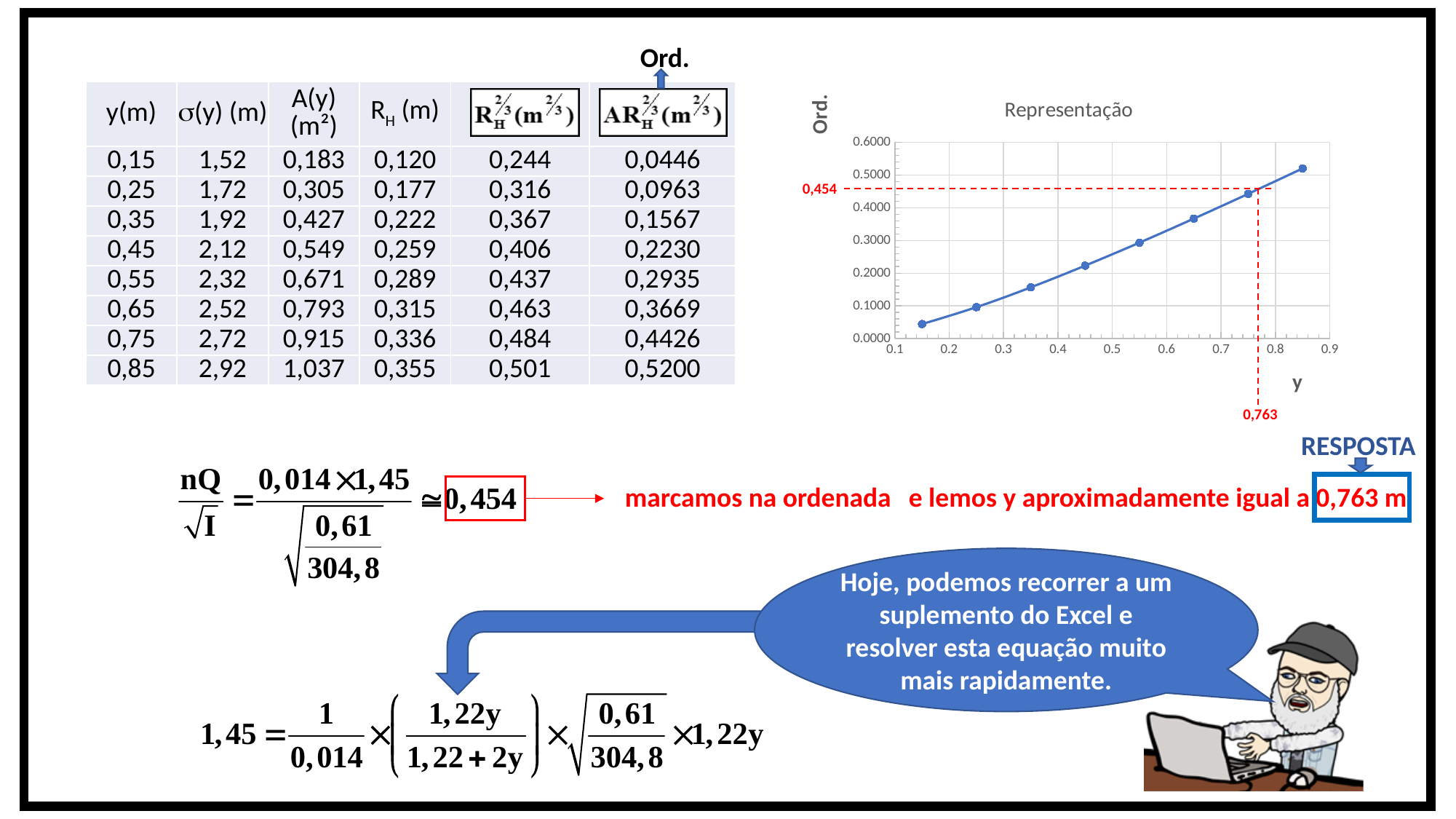
What is the title of the chart? Representação Is the plotted value at y = 0.85 greater or less than 0.5000? greater Is the plotted value at y = 0.45 greater or less than 0.2000? greater At which value of y is the plotted ordinate highest? 0.85 How many data points are plotted on the chart? 8 What kind of chart is shown on the slide? line chart Is the plotted value at y = 0.15 greater or less than 0.1000? less Do the plotted values rise or fall as y increases along the x axis? rise At which value of y is the plotted ordinate lowest? 0.15 Which is larger, the plotted value at y = 0.35 or at y = 0.75? y = 0.75 What ordinate value is marked by the red dashed line on the chart? 0,454